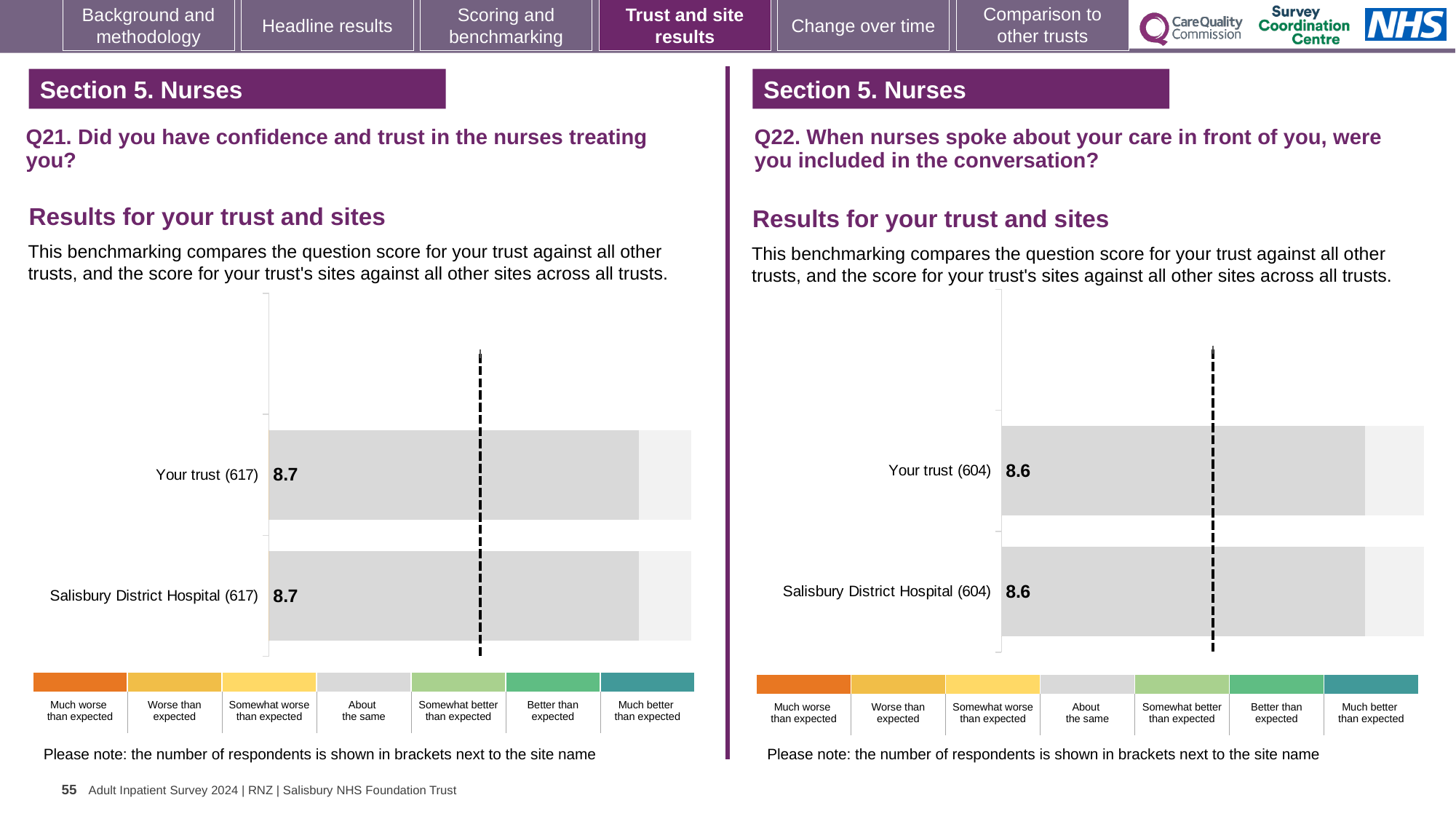
How many categories does the colour key below the Q21 chart on the left list? 7 In the Q22 chart on the right, what is the score for Salisbury District Hospital? 8.6 In the Q22 chart on the right, how many respondents are shown in brackets for Salisbury District Hospital? 604 In the Q21 chart on the left, what is the score for Your trust? 8.7 In the Q21 chart on the left, what is the score for Salisbury District Hospital? 8.7 How many bars are plotted in the Q22 chart on the right? 2 What kind of chart is the Q21 chart on the left? Bar chart In the Q21 chart on the left, how many respondents are shown in brackets for Your trust? 617 Is the score for Your trust in the Q22 chart on the right greater or less than the score for Your trust in the Q21 chart on the left? less In the Q22 chart on the right, what is the score for Your trust? 8.6 In the colour key below the Q22 chart on the right, what colour represents 'Much worse than expected'? Orange In the Q21 chart on the left, what is the difference between the score for Your trust and the score for Salisbury District Hospital? 0